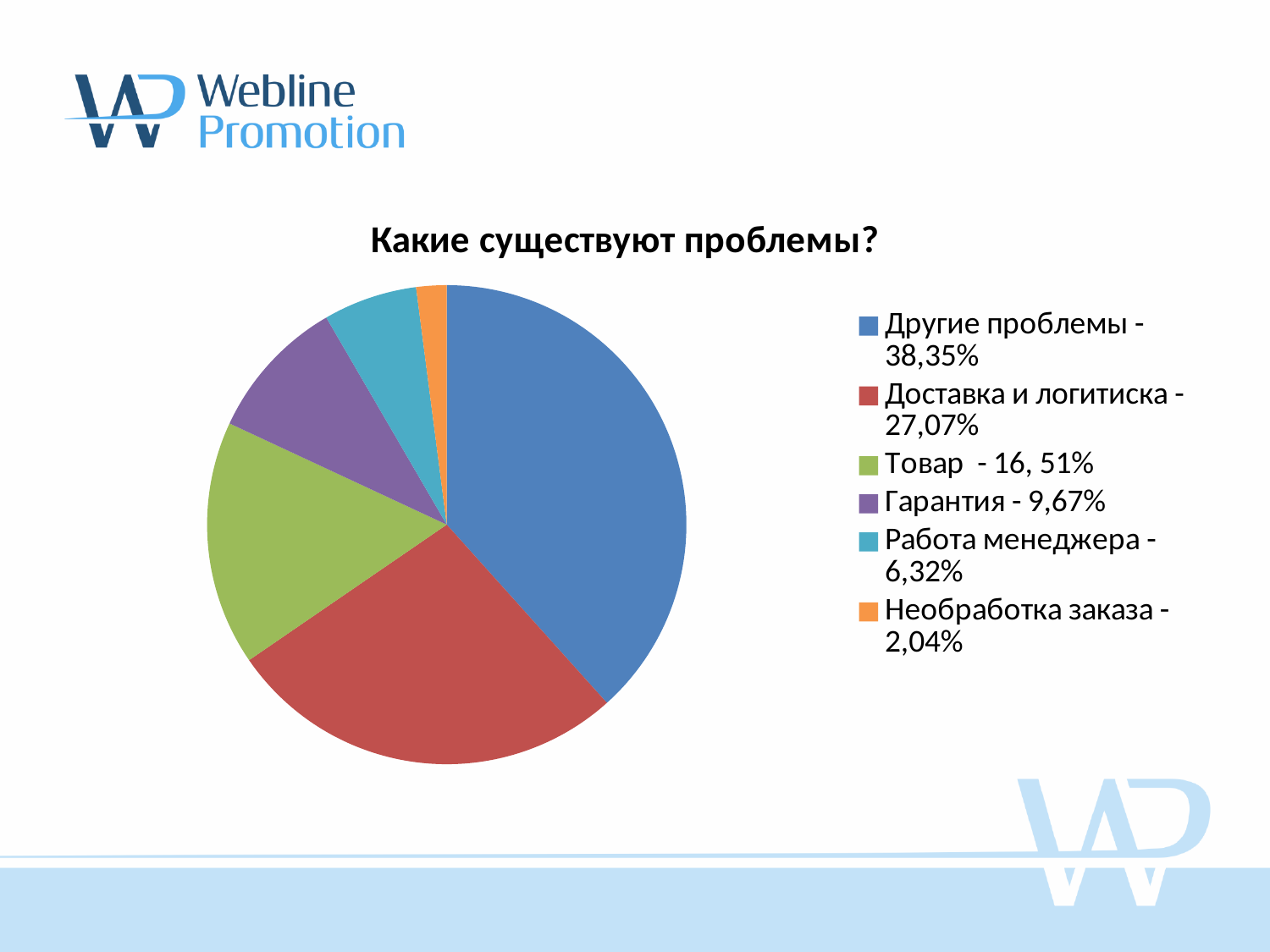
What is the value shown for 'Гарантия'? 9,67% Which category has the largest share of the pie? Другие проблемы What is the value shown for 'Доставка и логитиска'? 27,07% What is the title of the chart? Какие существуют проблемы? What is the value shown for 'Работа менеджера'? 6,32% How many slices does the pie chart have? 6 What share of the pie is 'Другие проблемы'? 38,35% What kind of chart is shown on the slide? Pie chart Which category has the smallest share of the pie? Необработка заказа Which is larger, the share for 'Гарантия' or the share for 'Работа менеджера'? Гарантия What is the value shown for 'Необработка заказа'? 2,04% What is the difference between the shares for 'Другие проблемы' and 'Доставка и логитиска'? 11,28%